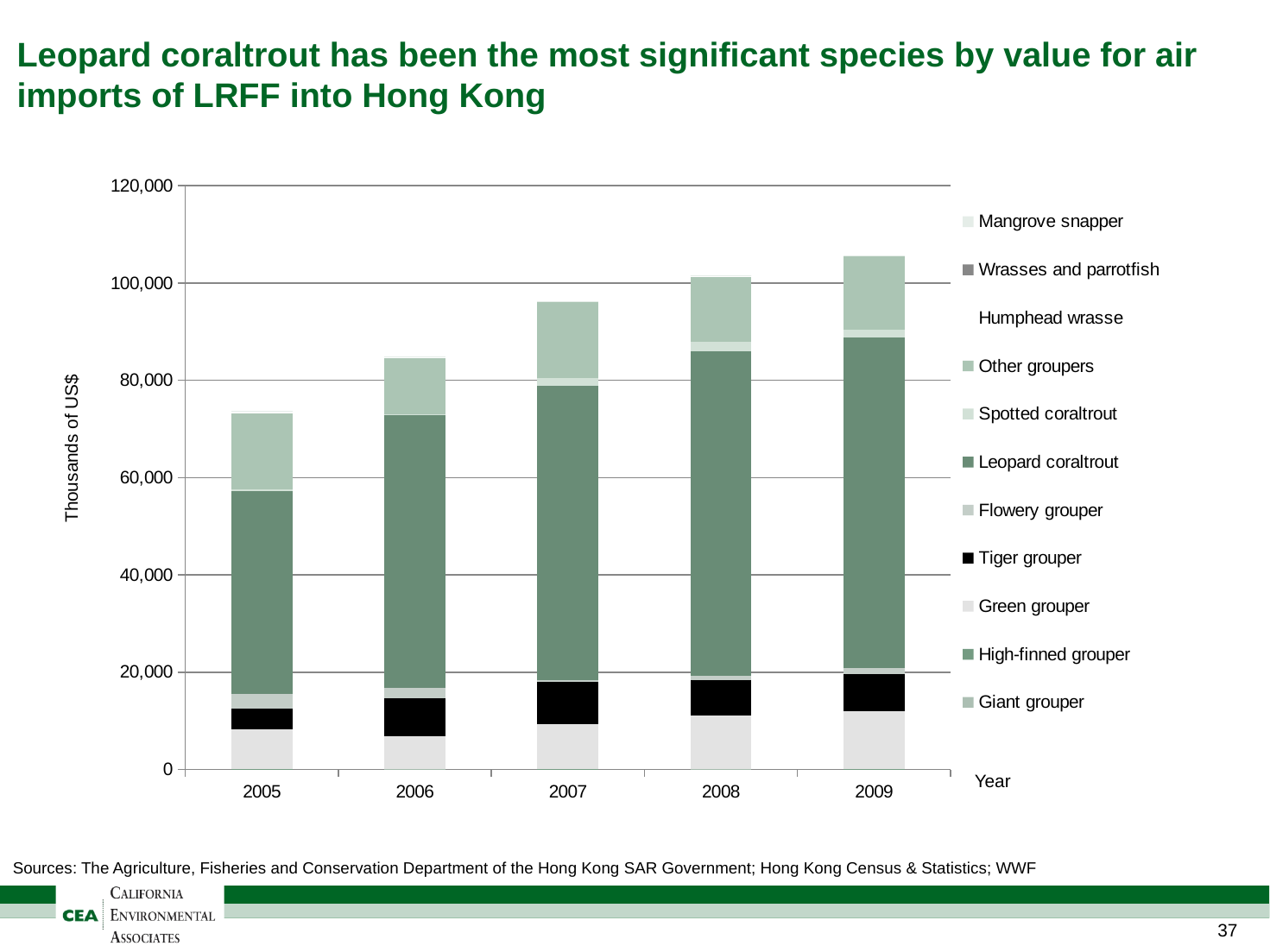
Which year has the lowest total bar in the chart? 2005 Do the total bar heights rise or fall from 2005 to 2009? Rise What kind of chart is shown on the slide? Stacked bar chart Which year has the highest total bar in the chart? 2009 Is the total value for 2009 greater or less than 100,000? greater Is the total value for 2007 greater or less than 100,000? less Is the total value for 2005 greater or less than 80,000? less How many series does the chart's legend list? 11 Which year has the larger total bar, 2006 or 2007? 2007 How many years are shown on the x axis of the chart? 5 What is the label on the vertical axis of the chart? Thousands of US$ Which series makes up the largest segment of each bar in the chart? Leopard coraltrout